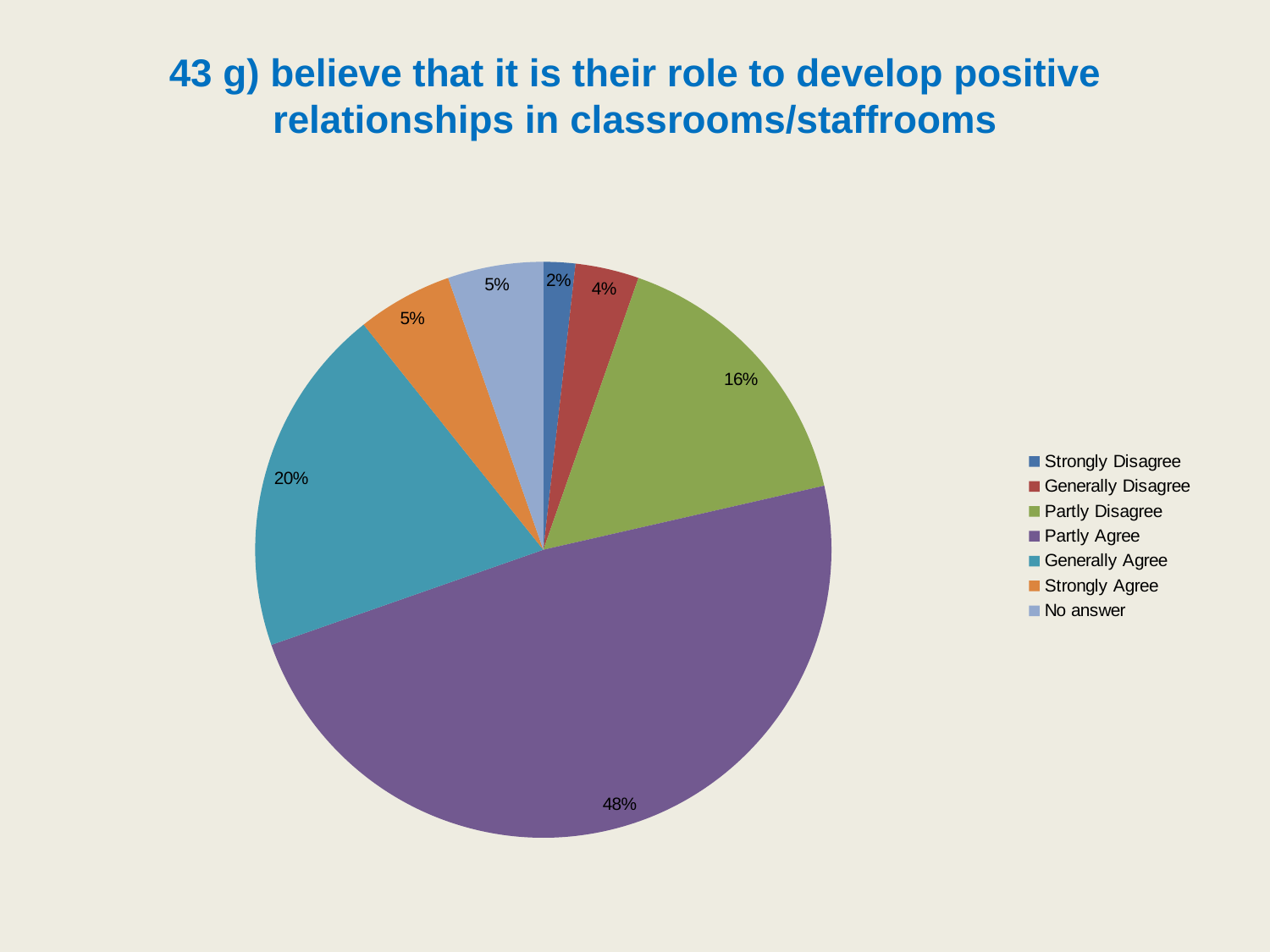
What is the difference between the Partly Agree share and the Generally Agree share? 28% What share of the pie is Generally Agree? 20% What share of the pie is Partly Agree? 48% How many categories does the legend list? 7 What is the title of the chart? 43 g) believe that it is their role to develop positive relationships in classrooms/staffrooms Which category has the largest slice of the pie? Partly Agree What share of the pie is Generally Disagree? 4% Which category has the smallest slice of the pie? Strongly Disagree What share of the pie is Strongly Disagree? 2% Which is larger, the Partly Disagree slice or the Generally Agree slice? Generally Agree What kind of chart is shown on the slide? pie chart What share of the pie is Partly Disagree? 16%